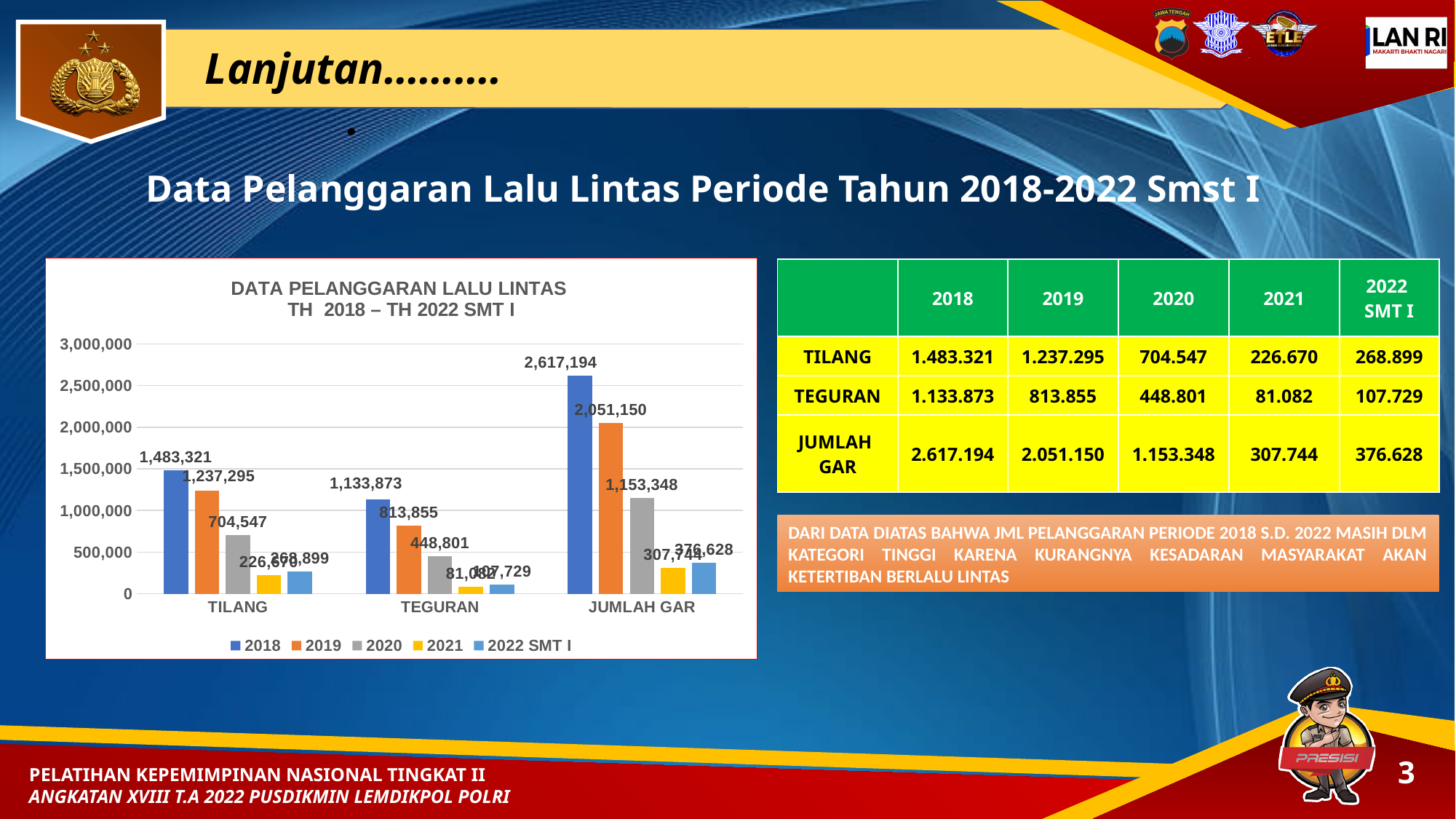
Which is larger for TILANG: the 2019 value or the 2020 value? 2019 What is the value for JUMLAH GAR in 2019? 2,051,150 What is the value for TILANG in 2018? 1,483,321 What is the value for TEGURAN in 2020? 448,801 Which category has the highest value for 2018? JUMLAH GAR What kind of chart is shown on the slide? Bar chart What is the value for TILANG in 2020? 704,547 How many categories are shown on the x axis of the chart? 3 Which series has the lowest value for TEGURAN? 2021 Do the values for JUMLAH GAR rise or fall from 2018 to 2021? Fall How many series does the chart legend list? 5 What is the difference between the 2018 and 2019 values for JUMLAH GAR? 566,044